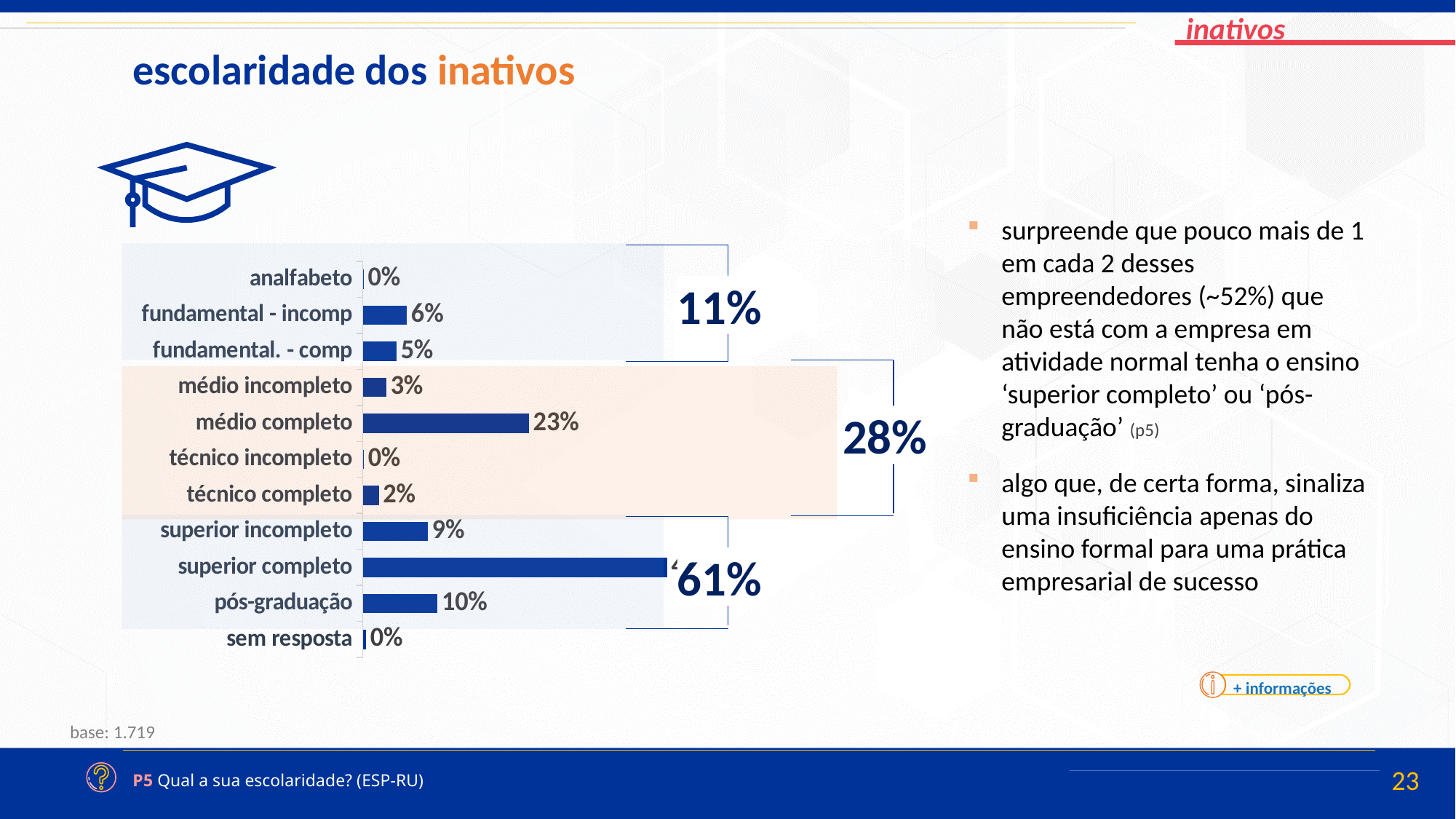
What is the value for 'fundamental - incomp'? 6% How many categories are shown in the chart? 11 What is the value for 'superior incompleto'? 9% What is the value for 'médio completo'? 23% What is the value for 'técnico completo'? 2% Which category has the highest value in the chart? superior completo What percentage is shown for the middle highlighted group (médio and técnico categories)? 28% What kind of chart is shown on the slide? bar chart What is the value for 'pós-graduação'? 10% What percentage is shown for the group of the three 'superior' and 'pós-graduação' categories (the bottom highlighted group)? 61% Which is larger, the value for 'pós-graduação' or the value for 'superior incompleto'? pós-graduação What is the difference between the values for 'médio completo' and 'médio incompleto'? 20%